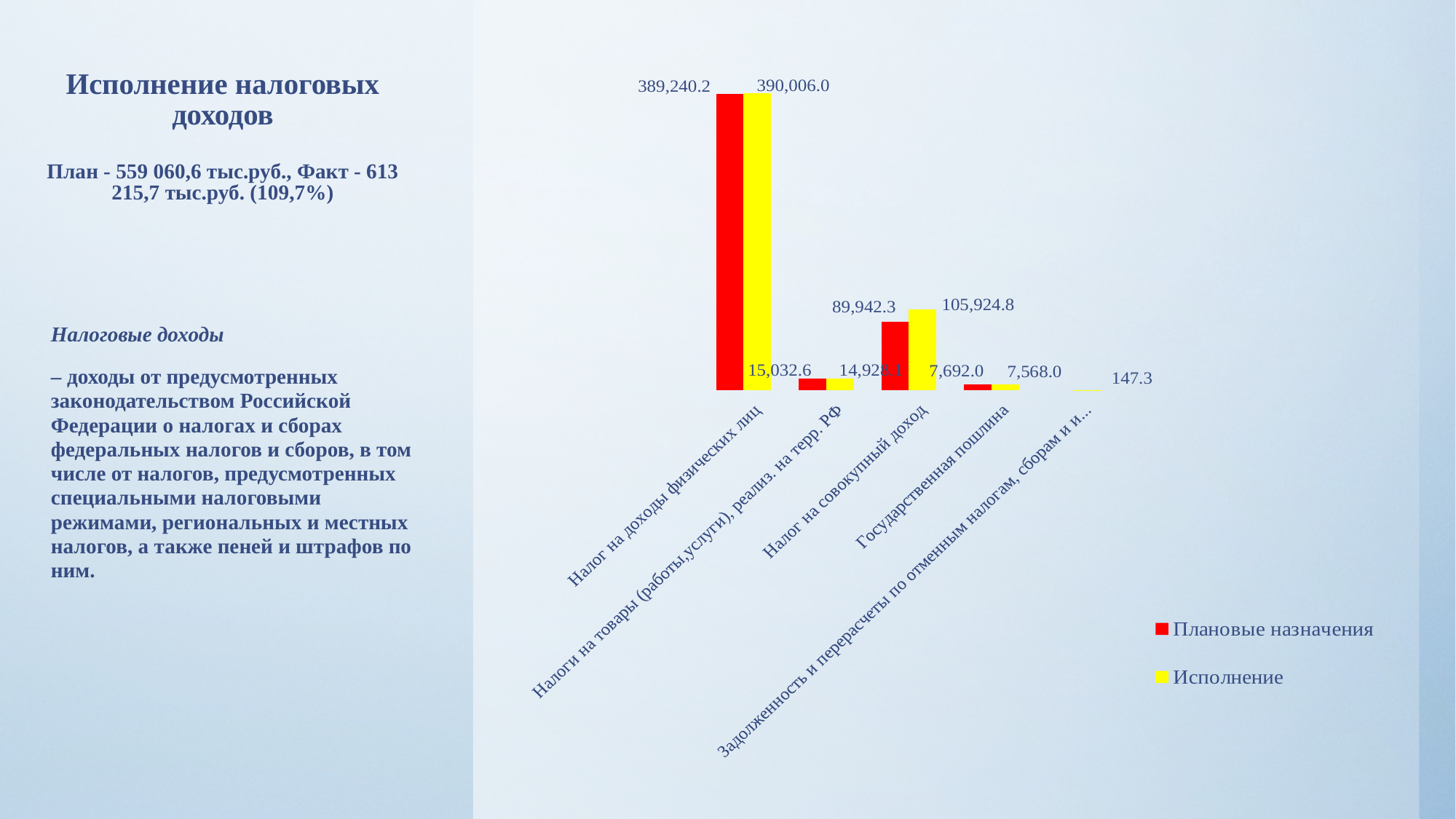
What is the value of Исполнение for Налог на совокупный доход? 105,924.8 What kind of chart is shown on the slide? bar chart What is the difference between Плановые назначения and Исполнение for Государственная пошлина? 124.0 Which category has the highest Исполнение value? Налог на доходы физических лиц What is the difference between Исполнение and Плановые назначения for Налог на совокупный доход? 15,982.5 How many categories are shown on the x axis of the chart? 5 How many series does the chart legend list? 2 Which is larger for Налоги на товары (работы,услуги), реализ. на терр. РФ: Плановые назначения or Исполнение? Плановые назначения What is the value of Исполнение for Налог на доходы физических лиц? 390,006.0 What is the value of Плановые назначения for Налог на доходы физических лиц? 389,240.2 Which colour represents the Исполнение series in the chart? yellow What is the value of Плановые назначения for Государственная пошлина? 7,692.0